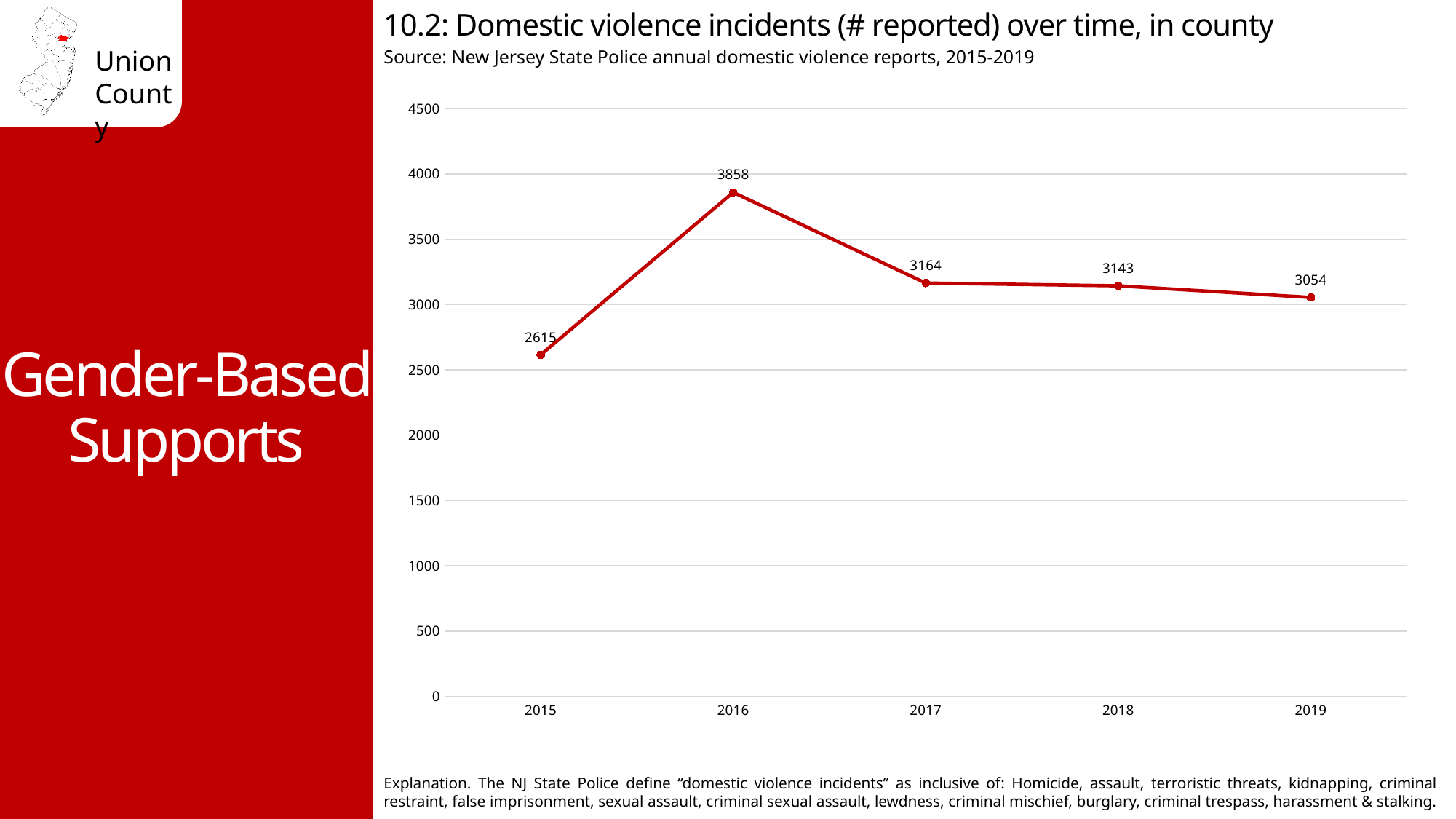
Which year has the lowest number of reported incidents? 2015 What is the value plotted for 2015? 2615 How many incidents were reported in 2019? 3054 Which year has the highest number of reported incidents? 2016 How many years are plotted on the chart? 5 Which year had more reported incidents, 2017 or 2019? 2017 How many domestic violence incidents were reported in 2016? 3858 Is the value for 2018 greater or less than 3000? greater Do the values rise or fall from 2016 to 2019? fall What kind of chart is shown on the slide? line chart What is the difference between the 2016 and 2017 values? 694 By how much did reported incidents change from 2015 to 2016? 1243